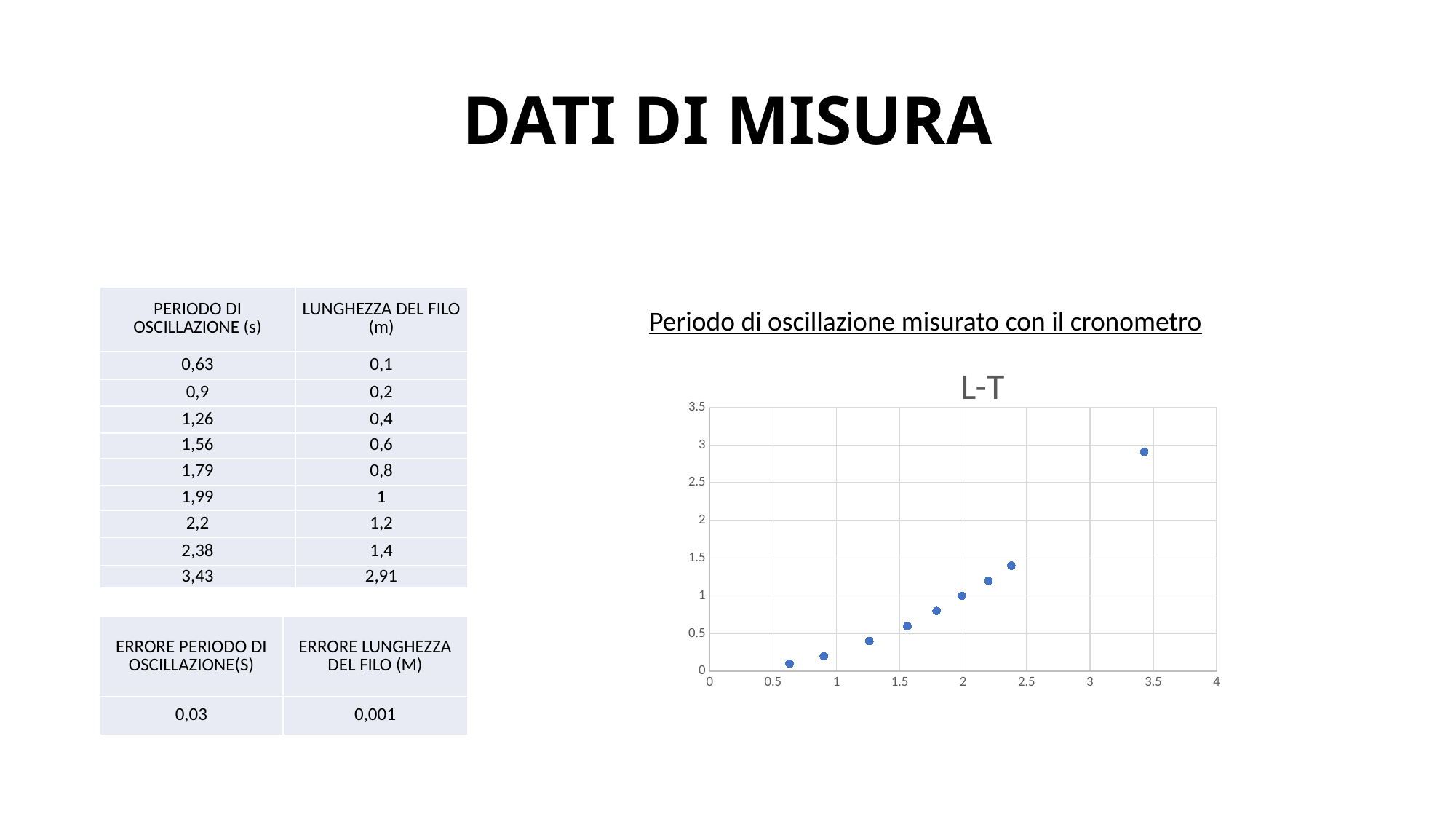
In the L-T chart, is the y value of the highest point greater or less than 2.5? greater In the L-T chart, is the y value of the point at x = 2 greater or less than 1.5? less In the L-T chart, how many points have a y value below 0.5? 3 What is the highest tick value shown on the y axis of the L-T chart? 3.5 In the L-T chart, how many points have an x value greater than 2.5? 1 In the L-T chart, is the y value of the lowest point greater or less than 0.5? less In the L-T chart, do the plotted values rise or fall as the x value increases? rise What kind of chart is the chart titled L-T? scatter chart What is the title of the chart on the right of the slide? L-T How many data points are plotted in the L-T chart? 9